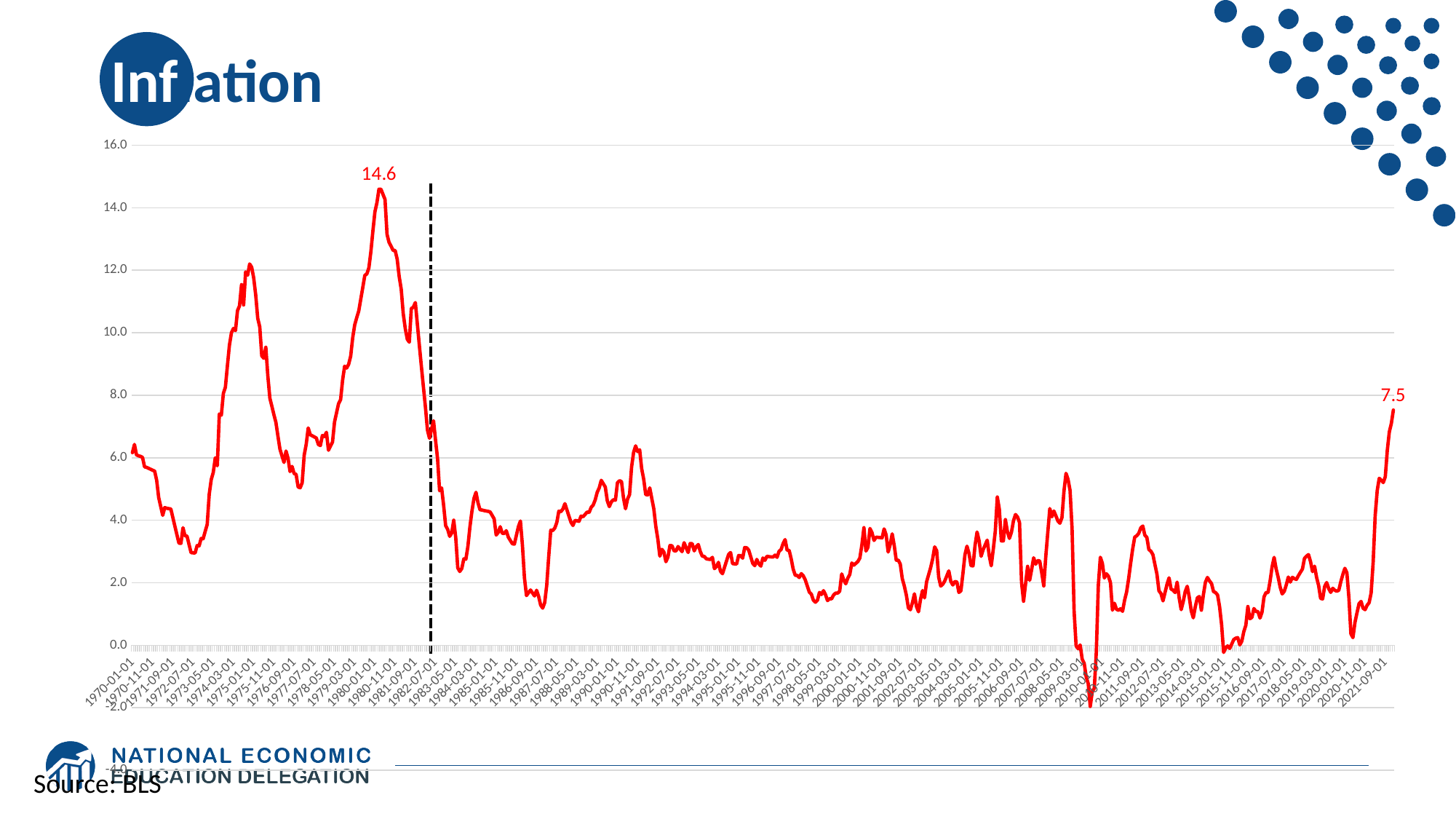
Is the inflation value around 2015-11-01 greater or less than 2.0? less What kind of chart is shown on the slide? Line chart Is the inflation value at 1970-01-01 greater or less than 4.0? greater Is the inflation value around 1975-01-01 greater or less than 10.0? greater What is the value labelled at the right end of the line, in 2021? 7.5 How many data series are plotted on the chart? 1 Which labelled value is larger: the 1980 peak or the 2021 end value? The 1980 peak (14.6) What is the difference between the two labelled values, 14.6 and 7.5? 7.1 What source is cited for the chart data? BLS Does the inflation line rise or fall between 2020-11-01 and 2021-09-01? Rises What is the peak value labelled on the inflation line chart? 14.6 What colour is the inflation line on the chart? Red